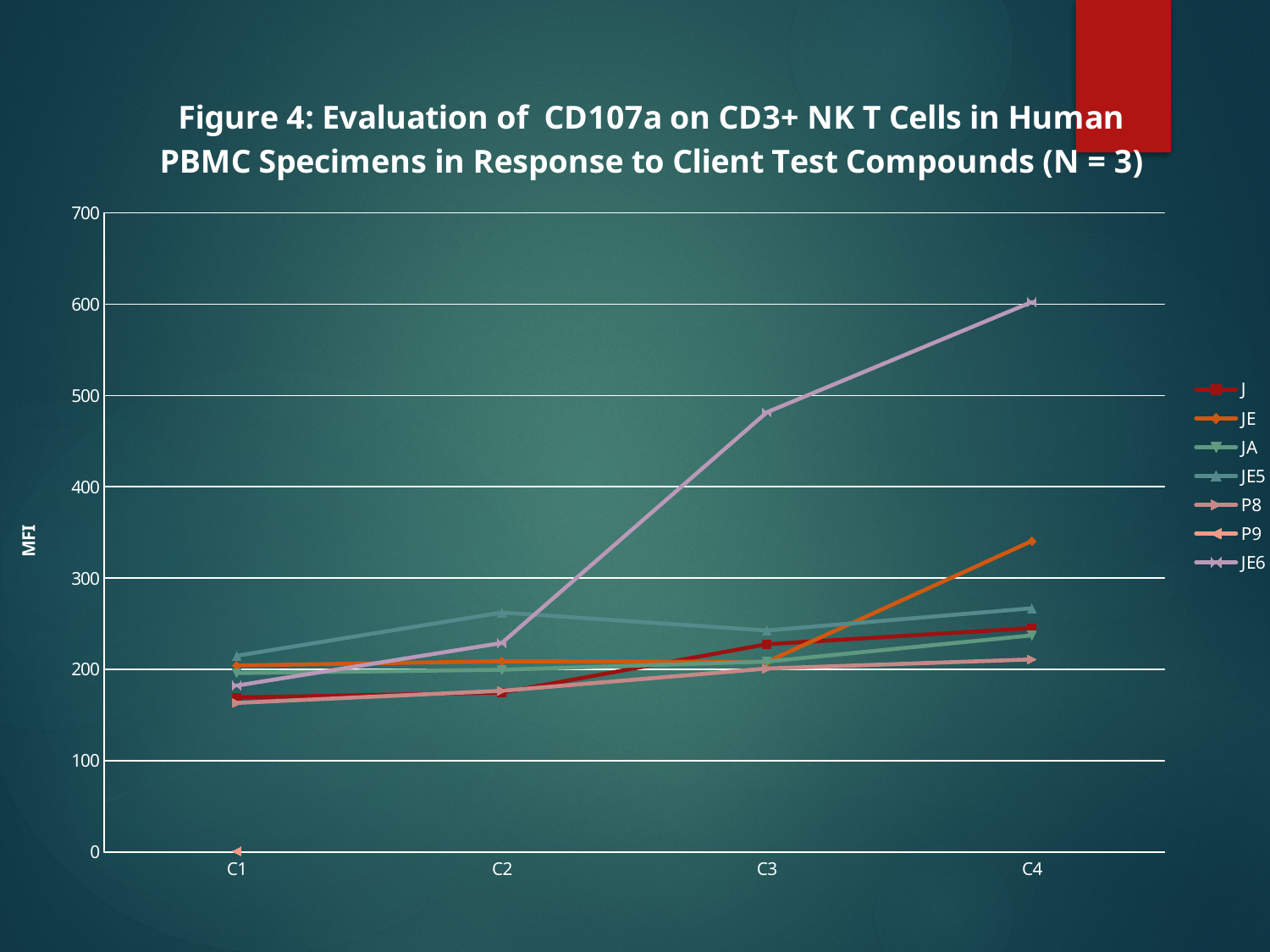
How many series does the legend list? 7 What is the label of the y axis? MFI How many categories are shown on the x axis? 4 What kind of chart is shown on the slide? line chart Which series has the highest value at C2? JE5 Is the value for JE6 at C3 greater or less than 400? greater Is the value for JE at C4 greater or less than 300? greater Is the value for JE5 at C2 greater or less than 300? less Does the JE6 series rise or fall from C1 to C4? rises At C4, which series has the larger value, JE6 or JE? JE6 Which series has the highest value at C4? JE6